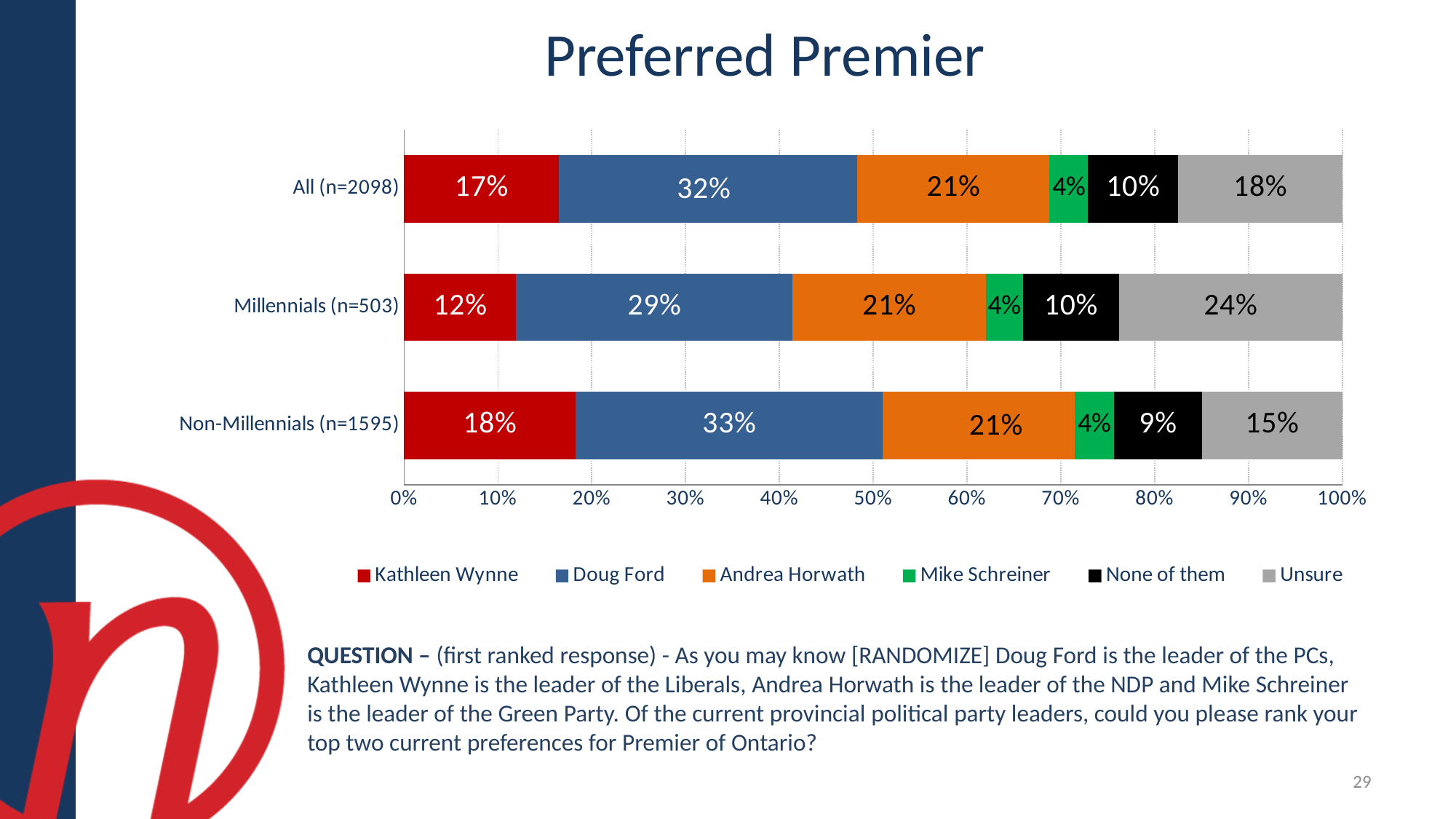
What percentage of Millennials (n=503) chose None of them? 10% What percentage of Millennials (n=503) preferred Kathleen Wynne? 12% What is the difference between the Unsure percentage for Millennials (n=503) and Non-Millennials (n=1595)? 9% What percentage of Non-Millennials (n=1595) were Unsure? 15% How many respondent groups are shown on the chart? 3 Which colour represents Mike Schreiner in the chart? Green What percentage of All respondents (n=2098) preferred Doug Ford? 32% Which group has the highest percentage for Doug Ford? Non-Millennials (n=1595) Which is larger for Millennials (n=503): the percentage for Andrea Horwath or the percentage for Unsure? Unsure What kind of chart is shown on the slide? Stacked bar chart Which group has the lowest percentage for Kathleen Wynne? Millennials (n=503) How many series does the legend list? 6